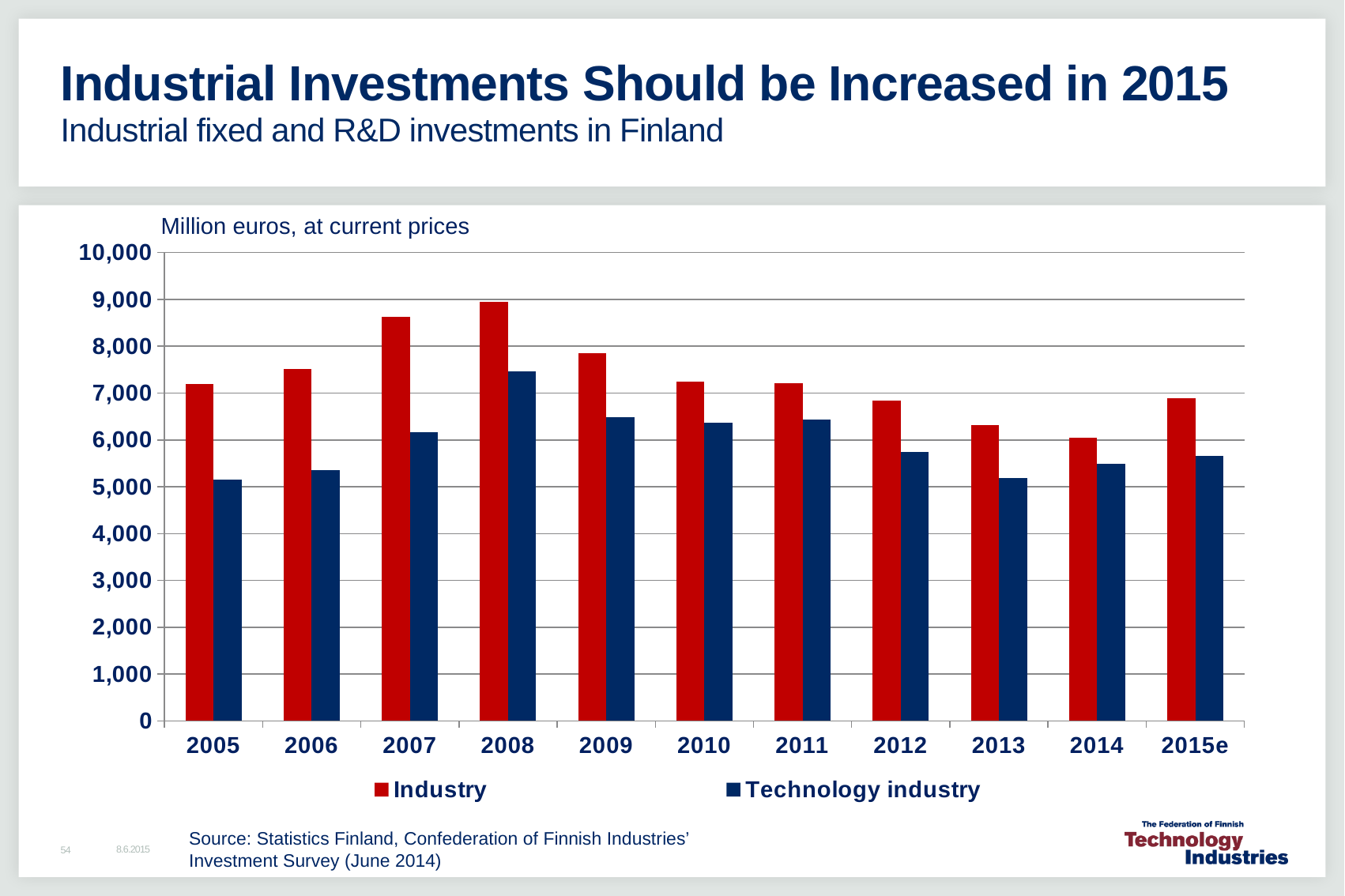
Which is larger, the Industry value for 2007 or for 2009? 2007 How many series does the legend list? 2 What kind of chart is shown on the slide? bar chart In which year is the Industry value highest? 2008 Do the Industry values rise or fall from 2008 to 2014? fall Is the Technology industry value for 2005 greater or less than 6,000? less Is the Industry value for 2014 greater or less than 7,000? less In which year is the Industry value lowest? 2014 How many years are shown on the x axis? 11 What unit is stated above the chart's y axis? Million euros, at current prices Is the Industry value for 2008 greater or less than 8,000? greater In which year is the Technology industry value highest? 2008